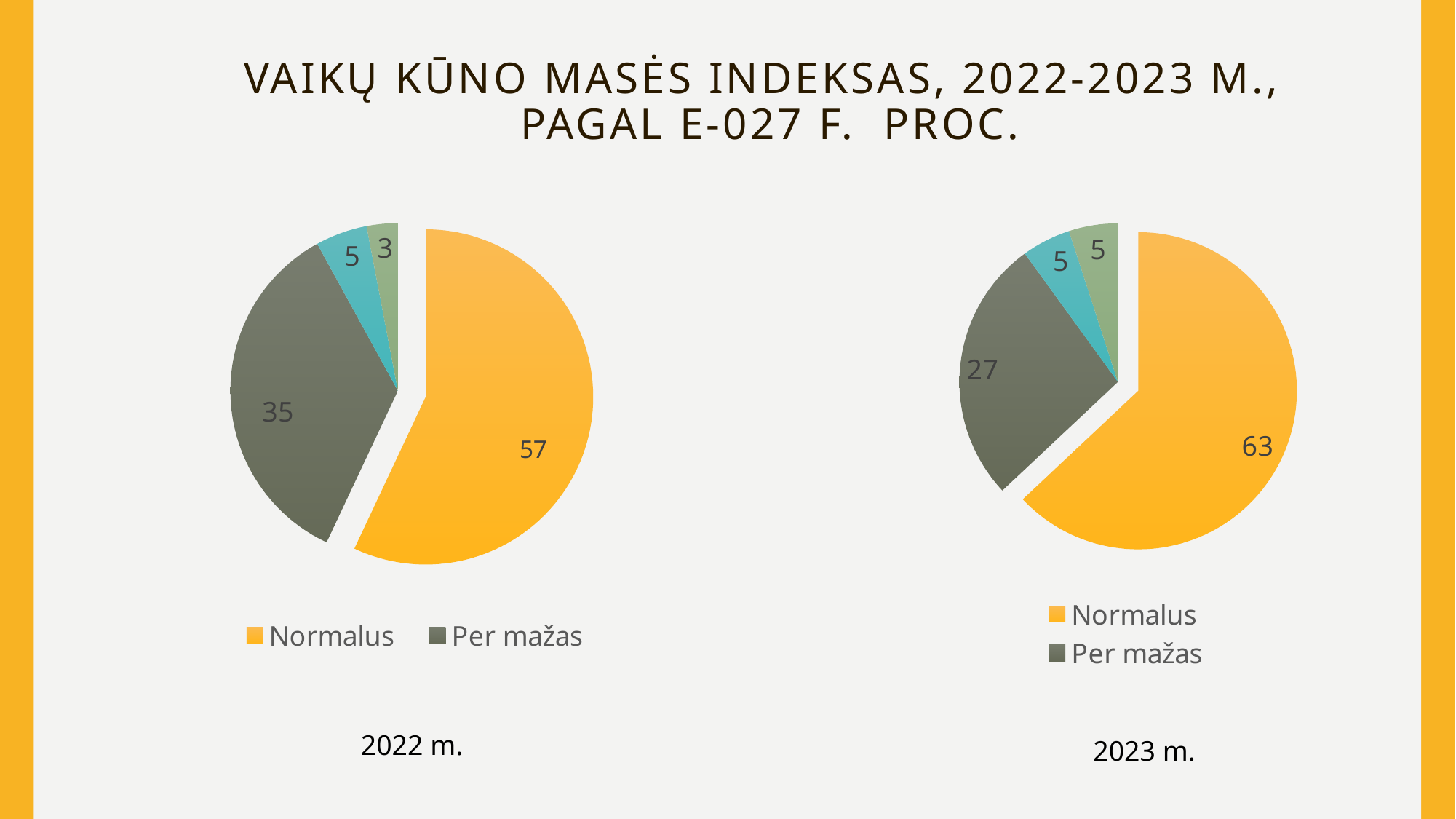
Which pie chart has the larger value for Normalus, 2022 m. or 2023 m.? 2023 m. In the 2023 m. pie chart, what is the difference between Normalus and Per mažas? 36 What kind of chart is used for the 2022 m. data? Pie chart In the 2023 m. pie chart, which category has the largest slice? Normalus In the 2022 m. pie chart, what is the value for Normalus? 57 In the 2022 m. pie chart, what is the value for Per mažas? 35 In the 2022 m. pie chart, what is the difference between Normalus and Per mažas? 22 What colour is the Normalus slice in the 2022 m. pie chart? Orange How many slices does the 2022 m. pie chart have? 4 How many entries does the legend of the 2023 m. chart list? 2 In the 2023 m. pie chart, what is the value for Normalus? 63 In the 2023 m. pie chart, what is the value for Per mažas? 27